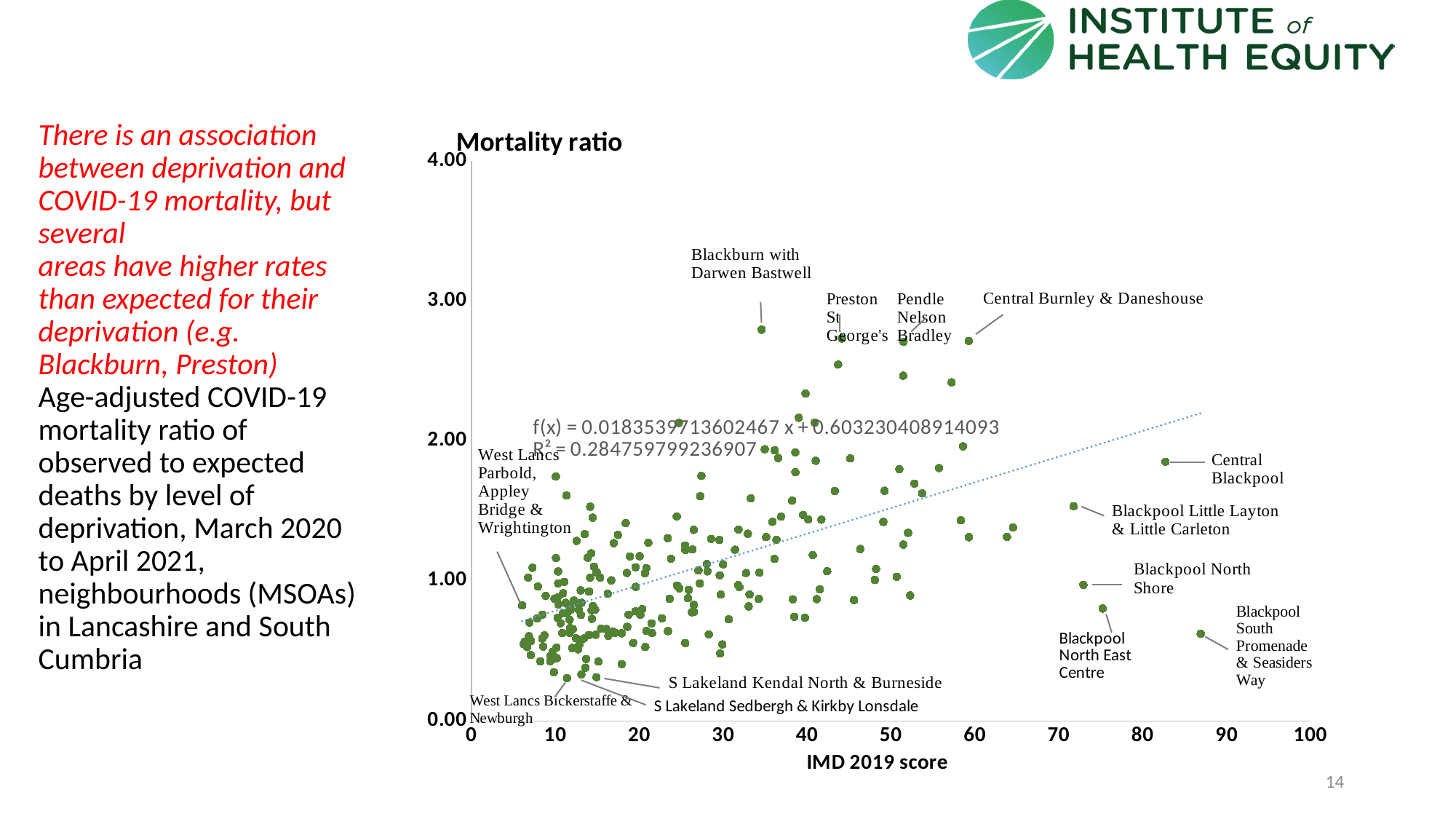
Is the mortality ratio for Blackburn with Darwen Bastwell greater or less than 3.00? less Does the fitted trend line show the mortality ratio rising or falling as the IMD 2019 score increases? rising What kind of chart is shown on the slide? scatter plot What is the title shown above the chart's y axis? Mortality ratio Is the mortality ratio for Central Blackpool greater or less than 2.00? less Which has the higher mortality ratio, Central Blackpool or Blackpool North East Centre? Central Blackpool Is the mortality ratio for Blackburn with Darwen Bastwell greater or less than 2.00? greater Which has the higher mortality ratio, Blackburn with Darwen Bastwell or Blackpool South Promenade & Seasiders Way? Blackburn with Darwen Bastwell What is the title of the chart's x axis? IMD 2019 score Which labelled neighbourhood has the highest IMD 2019 score on the chart? Blackpool South Promenade & Seasiders Way